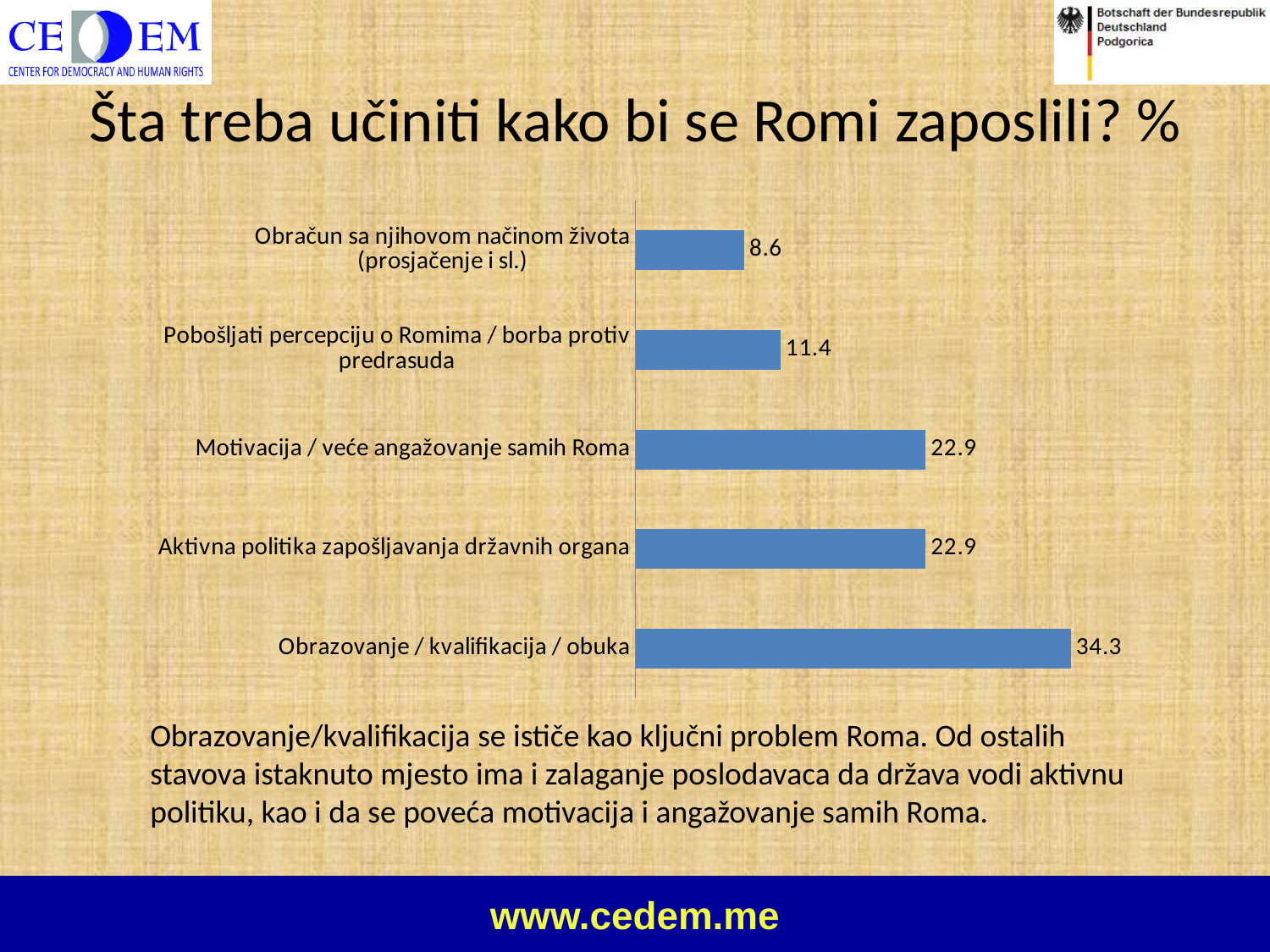
How many categories are shown in the chart? 5 What is the title of the slide containing the chart? Šta treba učiniti kako bi se Romi zaposlili? % What is the value for "Pobošljati percepciju o Romima / borba protiv predrasuda"? 11.4 What is the value for "Obrazovanje / kvalifikacija / obuka"? 34.3 Which category has the lowest value? Obračun sa njihovom načinom života (prosjačenje i sl.) Which category has the highest value? Obrazovanje / kvalifikacija / obuka What is the value for "Obračun sa njihovom načinom života (prosjačenje i sl.)"? 8.6 What is the difference between the values for "Obrazovanje / kvalifikacija / obuka" and "Aktivna politika zapošljavanja državnih organa"? 11.4 What is the value for "Motivacija / veće angažovanje samih Roma"? 22.9 What is the difference between the values for "Pobošljati percepciju o Romima / borba protiv predrasuda" and "Obračun sa njihovom načinom života (prosjačenje i sl.)"? 2.8 What kind of chart is shown on the slide? Bar chart Which is larger: the value for "Motivacija / veće angažovanje samih Roma" or the value for "Pobošljati percepciju o Romima / borba protiv predrasuda"? Motivacija / veće angažovanje samih Roma